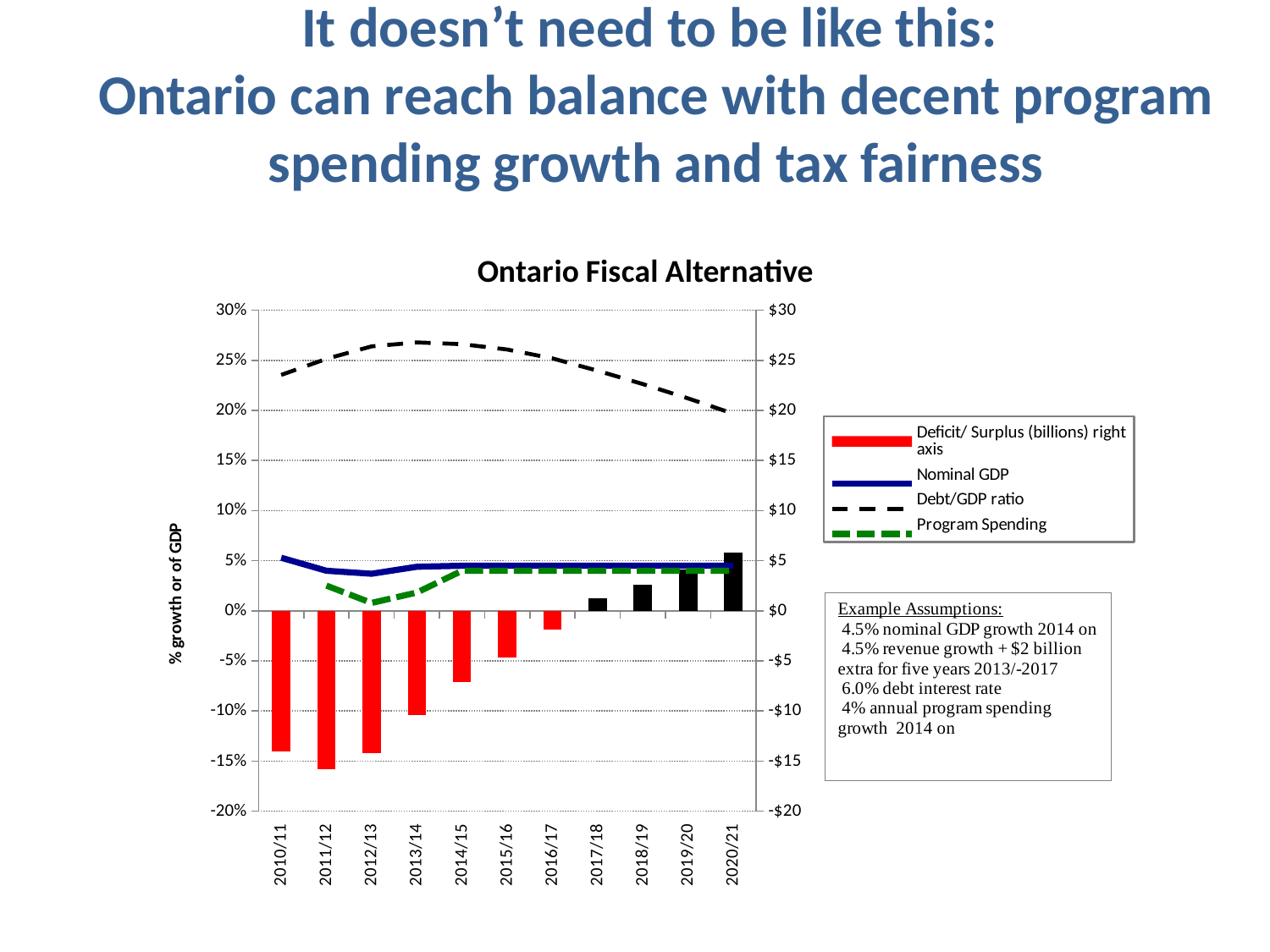
Does the Debt/GDP ratio rise or fall from 2014/15 to 2020/21? fall Which year has the highest Deficit/Surplus bar? 2020/21 Which year has the lowest (most negative) Deficit/Surplus bar? 2011/12 How many series does the chart's legend list? 4 Is the Deficit/Surplus value for 2013/14 greater or less than -$5? less Which year has the higher Nominal GDP growth, 2010/11 or 2012/13? 2010/11 What colour and line style represents Program Spending in the legend? Green dashed line What is the title of the chart? Ontario Fiscal Alternative Is the Debt/GDP ratio for 2013/14 greater or less than 25%? greater What kind of chart is shown on the slide? Combination bar and line chart How many fiscal years are shown on the x axis of the chart? 11 Is the Deficit/Surplus value for 2020/21 greater or less than $5? greater